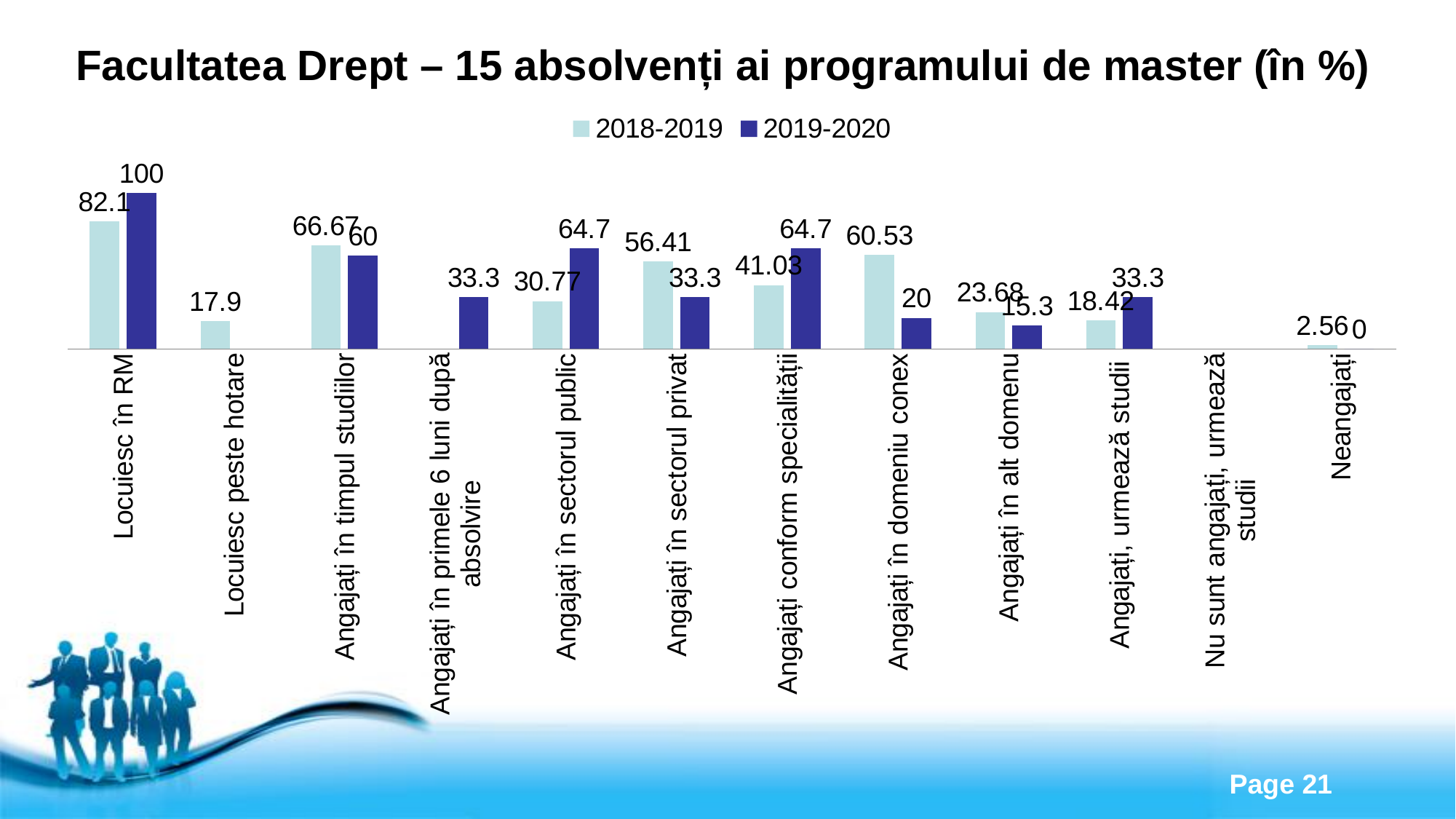
What is the difference between the 2019-2020 and 2018-2019 values for "Angajați în sectorul public"? 33.93 What is the 2018-2019 value for "Neangajați"? 2.56 For "Angajați conform specialității", which series has the larger value, 2018-2019 or 2019-2020? 2019-2020 What is the difference between the 2018-2019 and 2019-2020 values for "Angajați în timpul studiilor"? 6.67 What kind of chart is shown on the slide? Bar chart How many series does the legend list? 2 What is the 2018-2019 value for "Angajați în sectorul privat"? 56.41 For "Angajați în alt domenu", which series has the larger value, 2018-2019 or 2019-2020? 2018-2019 Which category has the highest 2018-2019 value? Locuiesc în RM What is the 2019-2020 value for "Locuiesc în RM"? 100 What is the 2019-2020 value for "Angajați în domeniu conex"? 20 How many categories are shown on the x axis of the chart? 12